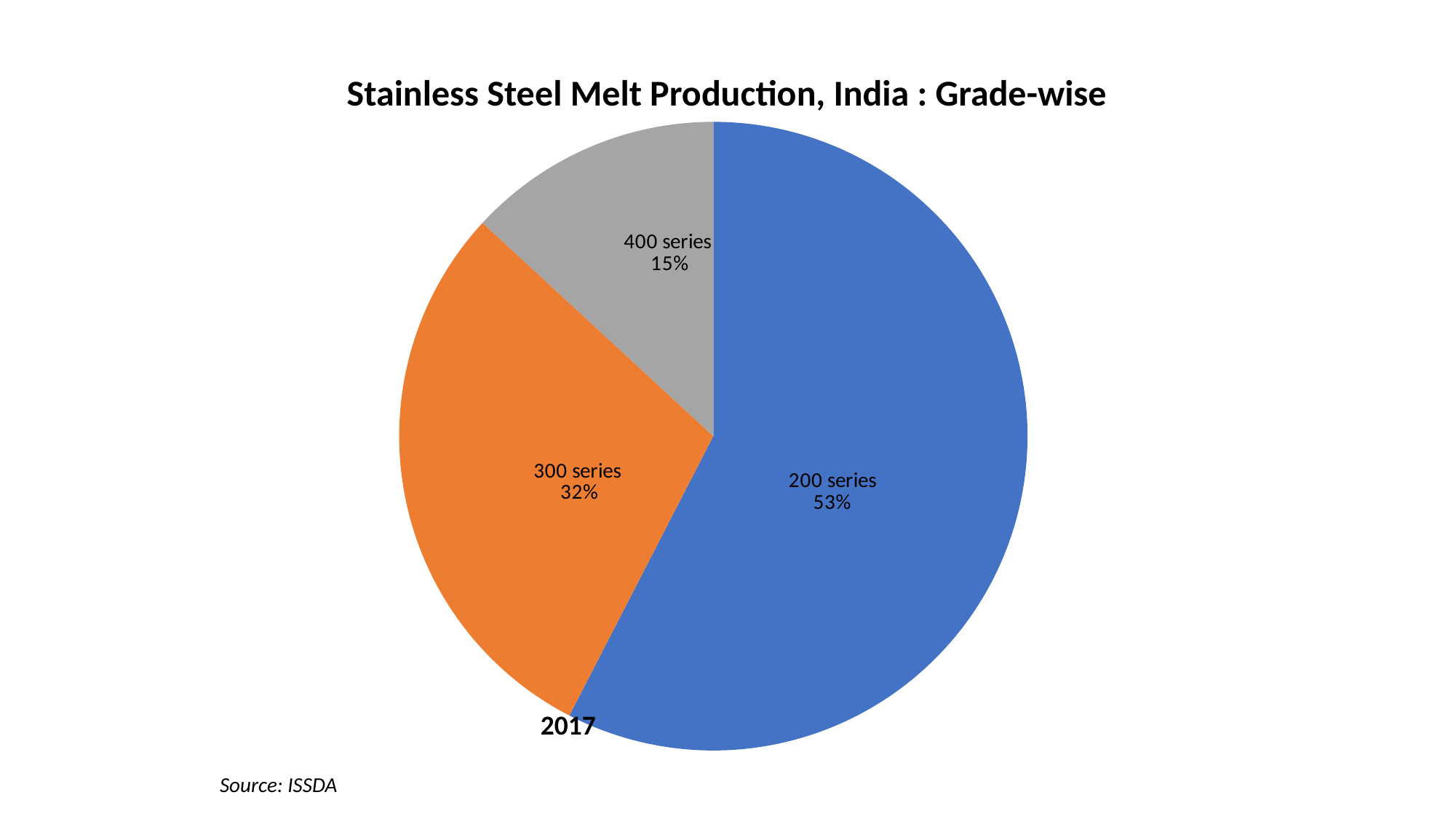
What kind of chart is shown on the slide? Pie chart Which grade series has the smallest share of production? 400 series What year is labelled on the chart? 2017 What share of stainless steel melt production does the 200 series account for? 53% What is the title of the chart? Stainless Steel Melt Production, India : Grade-wise How many grade series are shown in the pie chart? 3 Which has a larger share, the 300 series or the 400 series? 300 series What is the difference in percentage points between the 300 series and 400 series shares? 17 Which grade series has the largest share of production? 200 series What share of stainless steel melt production does the 300 series account for? 32% What share of stainless steel melt production does the 400 series account for? 15% What is the difference in percentage points between the 200 series and 300 series shares? 21